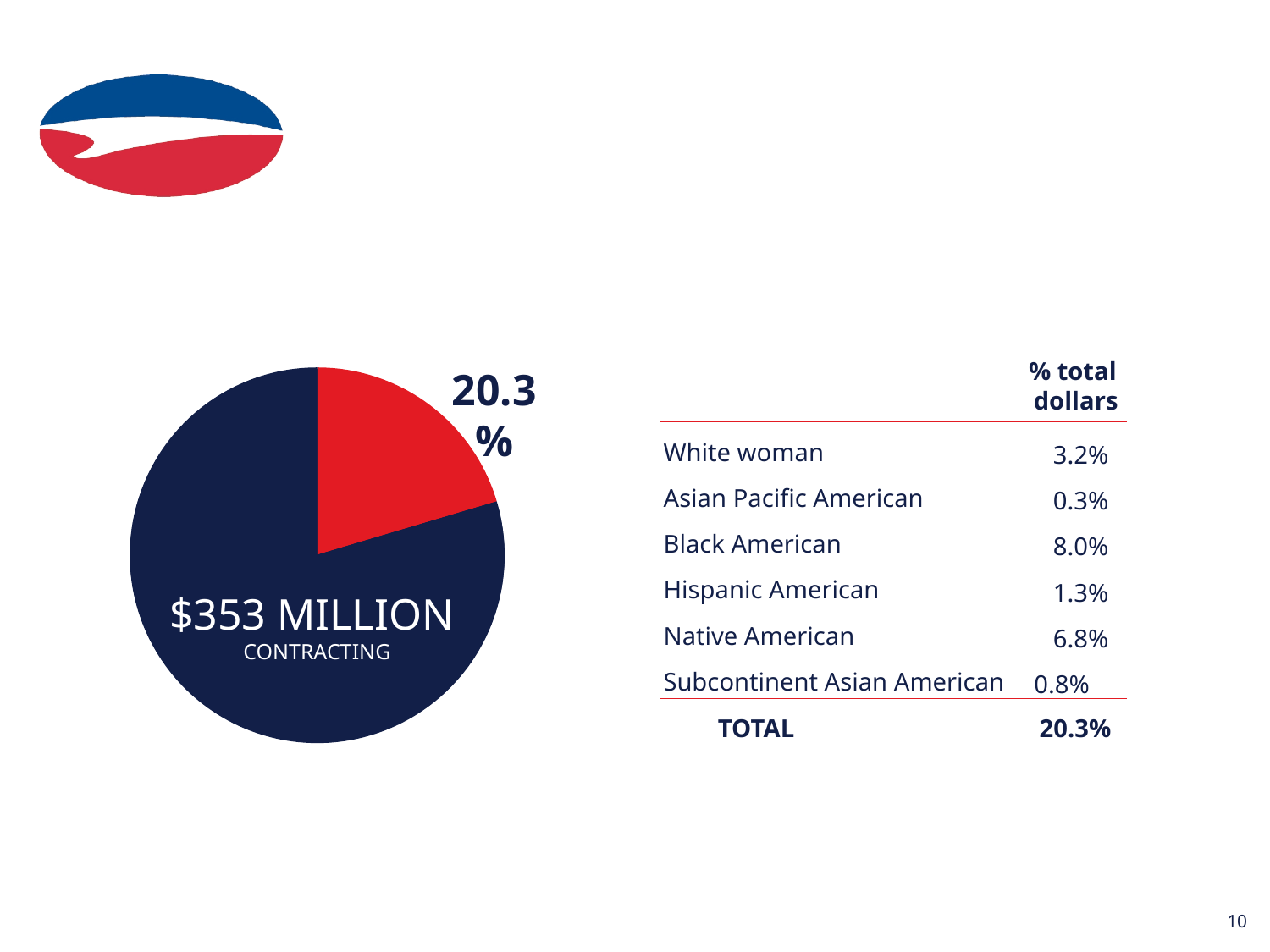
In the table next to the pie chart, which category has the highest % total dollars? Black American What kind of chart is shown on the left of the slide? pie chart What percentage is printed as the label on the red slice of the pie chart? 20.3% Is the red slice of the pie chart greater or less than 25% of the pie? less In the table next to the pie chart, what is the difference between the % total dollars for Black American and Native American? 1.2% What dollar amount is printed in the centre of the pie chart? $353 MILLION Which slice of the pie chart is larger, the red slice or the dark blue slice? dark blue In the table next to the pie chart, what is the % total dollars for Black American? 8.0% In the table next to the pie chart, what is the TOTAL % total dollars? 20.3% How many slices does the pie chart have? 2 In the table next to the pie chart, which category has the lowest % total dollars? Asian Pacific American What word appears below the dollar amount in the centre of the pie chart? CONTRACTING